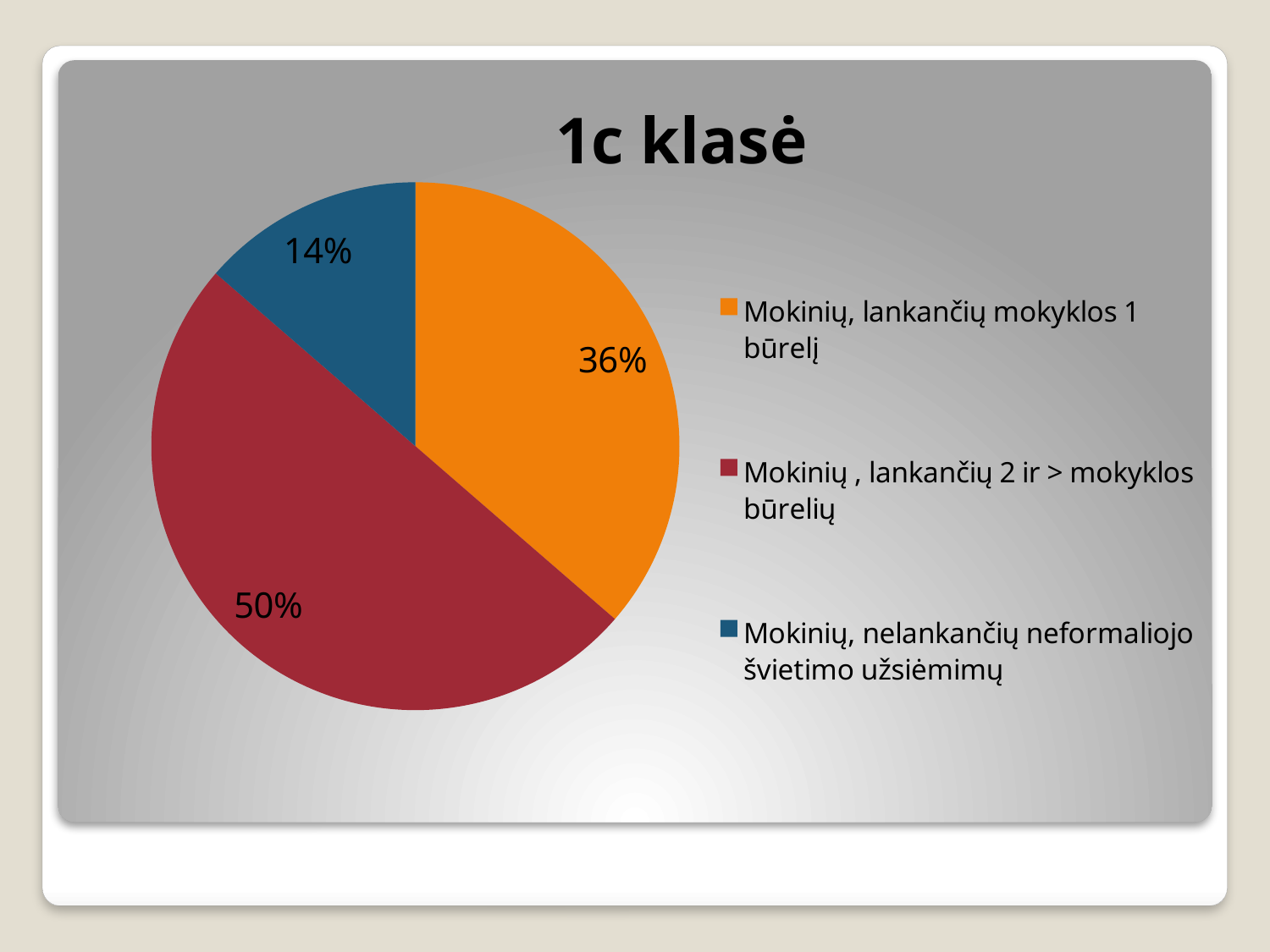
What share of the pie is labelled "Mokinių, nelankančių neformaliojo švietimo užsiėmimų"? 14% Which category has the smallest slice of the pie? Mokinių, nelankančių neformaliojo švietimo užsiėmimų How many categories does the pie chart show? 3 What is the difference in percentage points between the "Mokinių, lankančių mokyklos 1 būrelį" slice and the "Mokinių, nelankančių neformaliojo švietimo užsiėmimų" slice? 22% What share of the pie is labelled "Mokinių , lankančių 2 ir > mokyklos būrelių"? 50% Which category has the largest slice of the pie? Mokinių , lankančių 2 ir > mokyklos būrelių What share of the pie is labelled "Mokinių, lankančių mokyklos 1 būrelį"? 36% What is the difference in percentage points between the "Mokinių , lankančių 2 ir > mokyklos būrelių" slice and the "Mokinių, lankančių mokyklos 1 būrelį" slice? 14% Which is larger: the slice for "Mokinių, lankančių mokyklos 1 būrelį" or the slice for "Mokinių, nelankančių neformaliojo švietimo užsiėmimų"? Mokinių, lankančių mokyklos 1 būrelį What kind of chart is shown on the slide? Pie chart What is the title of the chart? 1c klasė What colour is the slice for "Mokinių, nelankančių neformaliojo švietimo užsiėmimų"? Blue